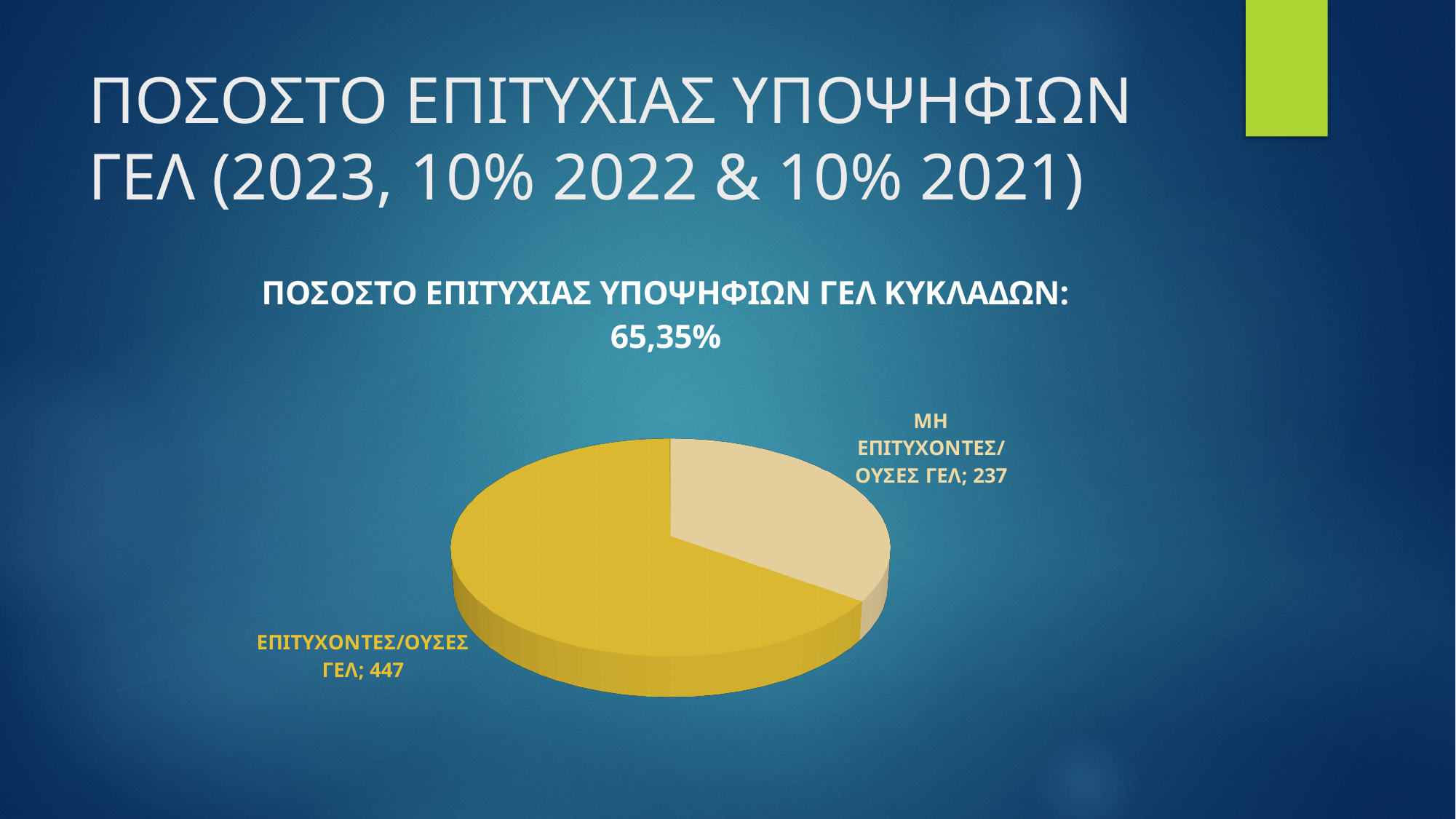
What is the value for ΜΗ ΕΠΙΤΥΧΟΝΤΕΣ/ΟΥΣΕΣ ΓΕΛ? 237 What share of the pie does the ΕΠΙΤΥΧΟΝΤΕΣ/ΟΥΣΕΣ ΓΕΛ slice represent? 65,35% Which slice of the pie is the smallest? ΜΗ ΕΠΙΤΥΧΟΝΤΕΣ/ΟΥΣΕΣ ΓΕΛ What success percentage is stated in the chart title? 65,35% What is the title of the pie chart? ΠΟΣΟΣΤΟ ΕΠΙΤΥΧΙΑΣ ΥΠΟΨΗΦΙΩΝ ΓΕΛ ΚΥΚΛΑΔΩΝ: 65,35% What type of chart is shown on the slide? pie chart What is the value for ΕΠΙΤΥΧΟΝΤΕΣ/ΟΥΣΕΣ ΓΕΛ? 447 What is the total of all slices in the pie chart? 684 Which slice of the pie is the largest? ΕΠΙΤΥΧΟΝΤΕΣ/ΟΥΣΕΣ ΓΕΛ What is the difference between the values for ΕΠΙΤΥΧΟΝΤΕΣ/ΟΥΣΕΣ ΓΕΛ and ΜΗ ΕΠΙΤΥΧΟΝΤΕΣ/ΟΥΣΕΣ ΓΕΛ? 210 How many slices does the pie chart have? 2 Which is larger: ΕΠΙΤΥΧΟΝΤΕΣ/ΟΥΣΕΣ ΓΕΛ or ΜΗ ΕΠΙΤΥΧΟΝΤΕΣ/ΟΥΣΕΣ ΓΕΛ? ΕΠΙΤΥΧΟΝΤΕΣ/ΟΥΣΕΣ ΓΕΛ